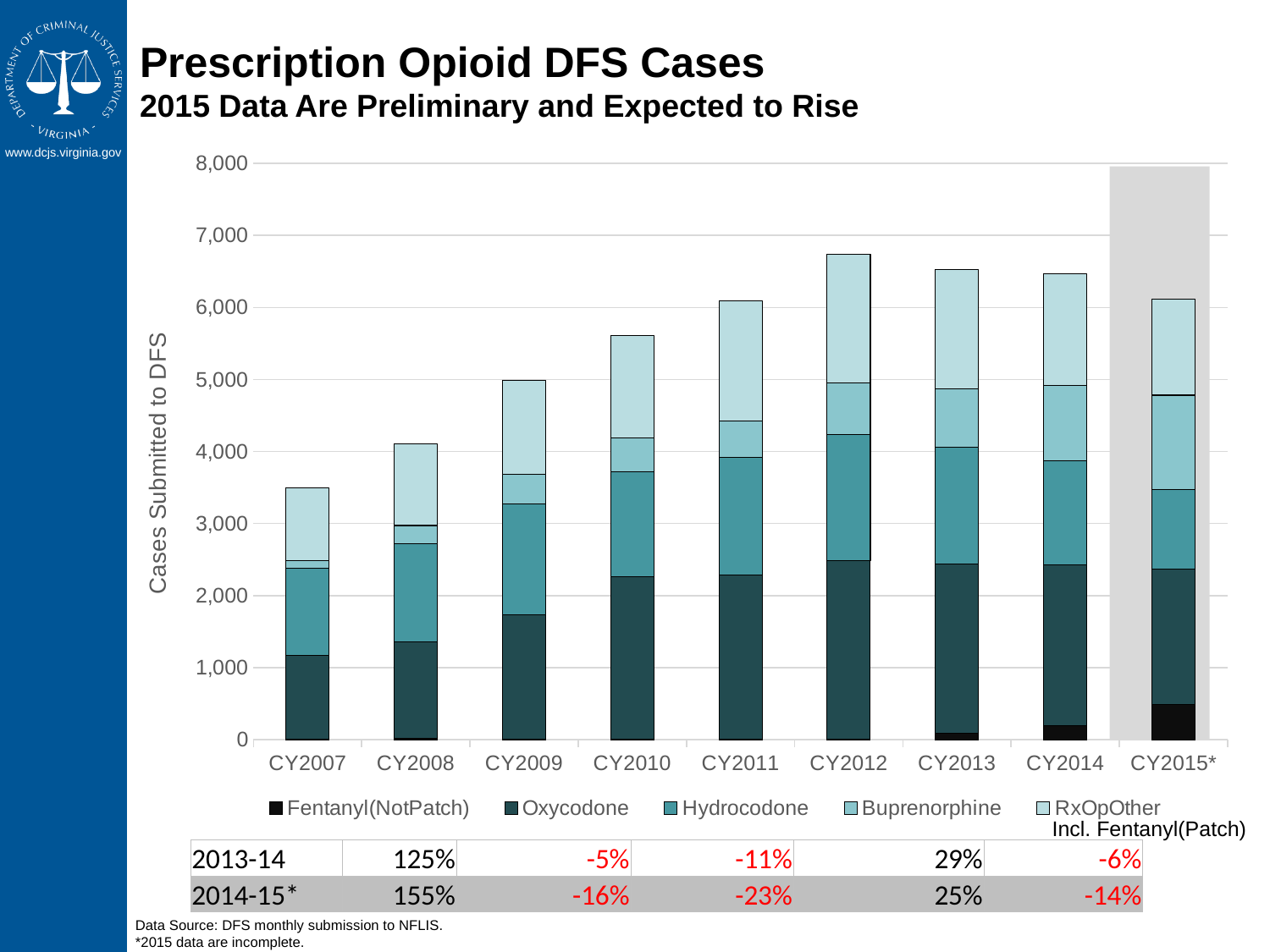
Which year has a larger total of cases, CY2008 or CY2009? CY2009 According to the table below the chart, what is the 2014-15* percentage change for Fentanyl(NotPatch)? 155% Is the total number of cases for CY2012 greater or less than 6,000? greater Do the total cases rise or fall from CY2007 to CY2012? rise What kind of chart is shown on the slide? stacked bar chart Which year has the lowest total of cases submitted to DFS? CY2007 Is the total number of cases for CY2007 greater or less than 4,000? less What is the label on the y axis of the chart? Cases Submitted to DFS How many series does the chart legend list? 5 Which year has the highest total of cases submitted to DFS? CY2012 Is the total number of cases for CY2010 greater or less than 5,000? greater How many calendar years (categories) are shown on the x axis of the chart? 9